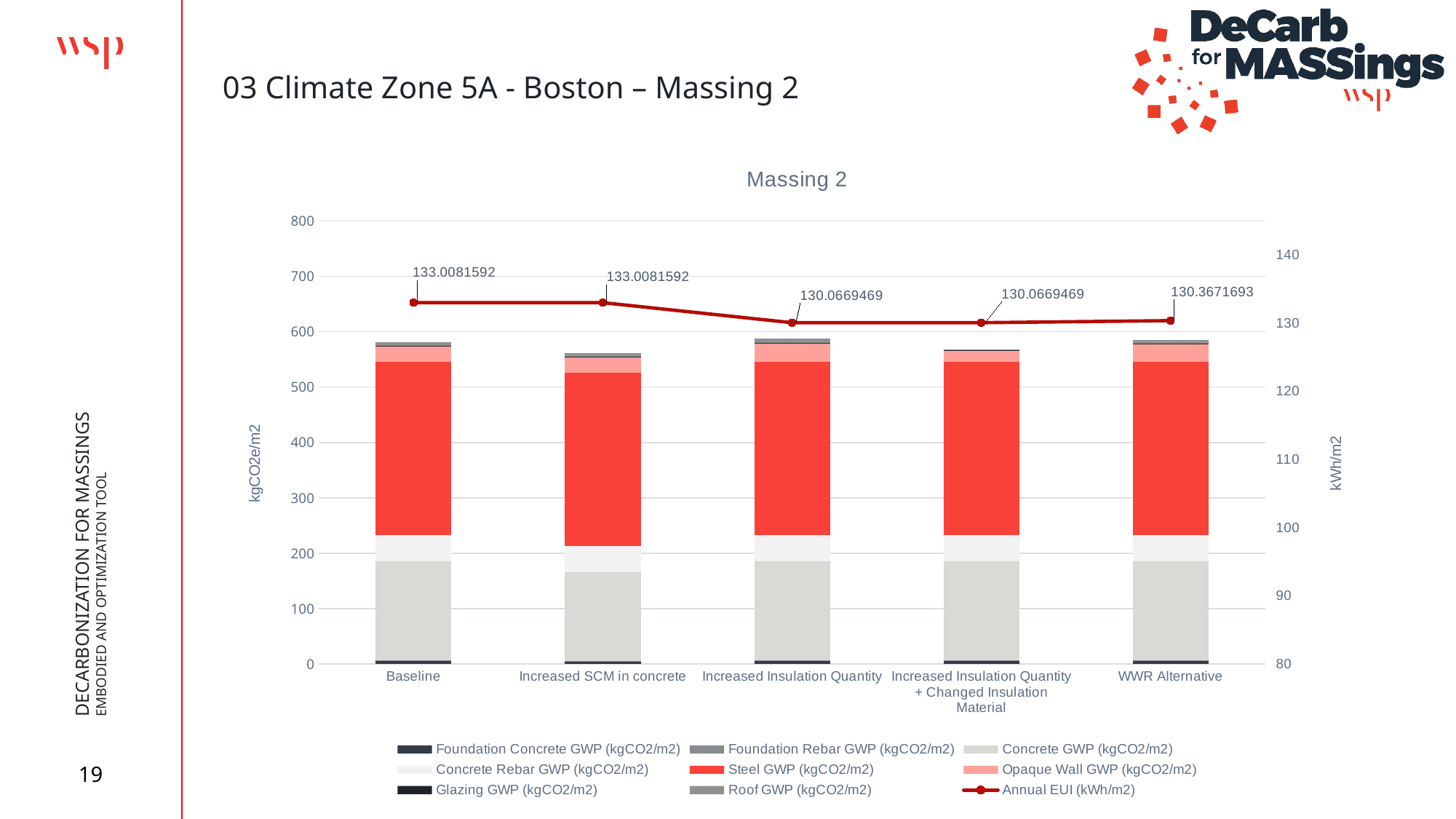
How many categories are shown on the x axis? 5 What is the difference in Annual EUI between Baseline and Increased Insulation Quantity? 2.9412123 What is the Annual EUI (kWh/m2) value for WWR Alternative? 130.3671693 What is the Annual EUI (kWh/m2) value for Increased SCM in concrete? 133.0081592 How many series does the legend list? 9 What is the Annual EUI (kWh/m2) value for Baseline? 133.0081592 Is the total stacked bar value for Baseline greater or less than 500 kgCO2e/m2? greater What is the difference in Annual EUI between WWR Alternative and Increased Insulation Quantity + Changed Insulation Material? 0.3002224 Does the Annual EUI line rise or fall from Baseline to Increased Insulation Quantity? fall Which has the larger Annual EUI, Baseline or WWR Alternative? Baseline Is the total stacked bar value for Increased SCM in concrete greater or less than 600 kgCO2e/m2? less What is the Annual EUI (kWh/m2) value for Increased Insulation Quantity? 130.0669469